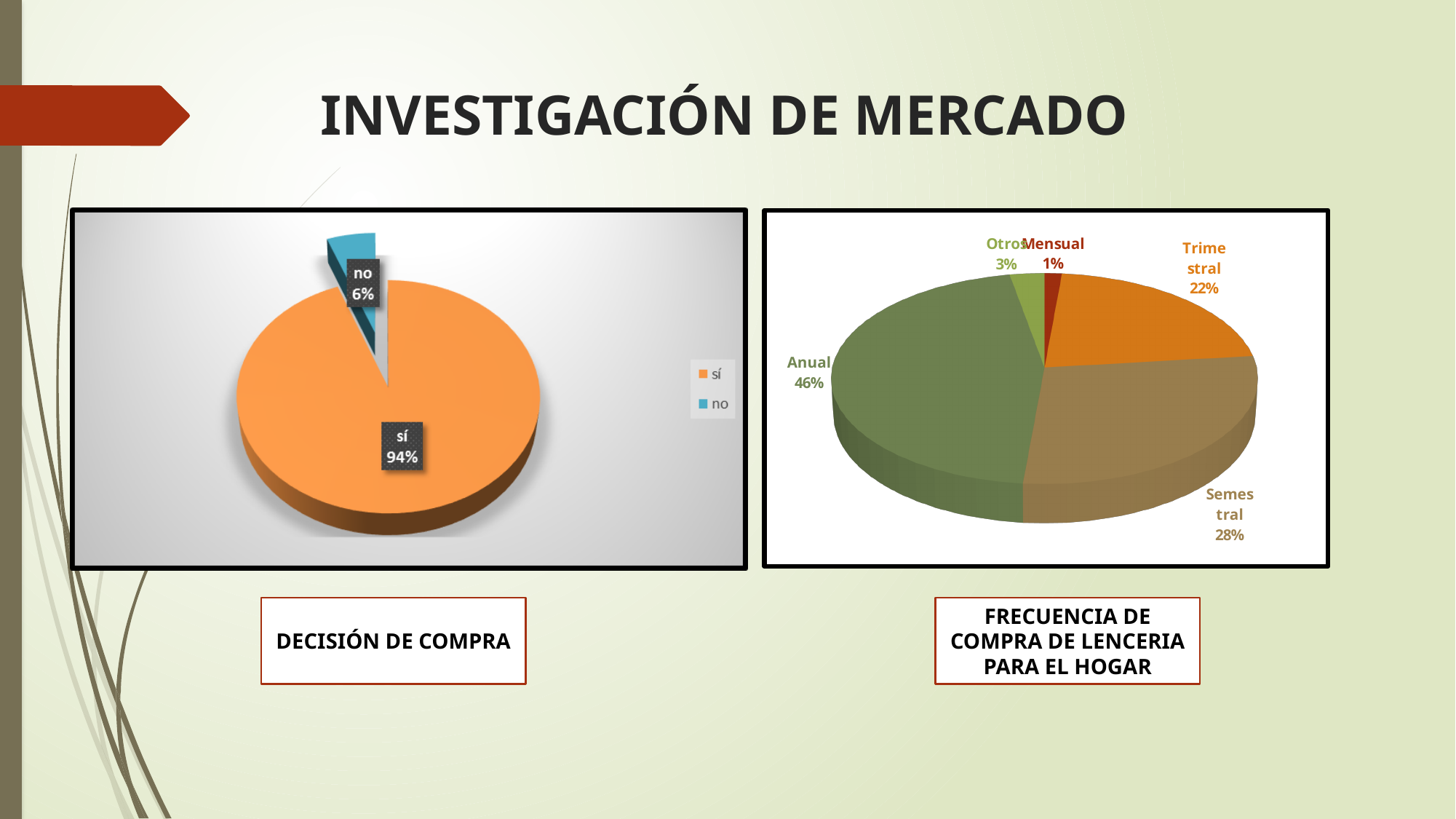
In the FRECUENCIA DE COMPRA DE LENCERIA PARA EL HOGAR chart on the right, which category has the largest share? Anual In the FRECUENCIA DE COMPRA DE LENCERIA PARA EL HOGAR chart on the right, which category has the smallest share? Mensual In the FRECUENCIA DE COMPRA DE LENCERIA PARA EL HOGAR chart on the right, what is the difference between the 'Semestral' and 'Trimestral' shares? 6% In the DECISIÓN DE COMPRA chart on the left, what is the difference between the 'sí' and 'no' shares? 88% In the FRECUENCIA DE COMPRA DE LENCERIA PARA EL HOGAR chart on the right, what share is 'Semestral'? 28% In the DECISIÓN DE COMPRA chart on the left, what share of the pie is 'no'? 6% In the DECISIÓN DE COMPRA chart on the left, what share of the pie is 'sí'? 94% In the FRECUENCIA DE COMPRA DE LENCERIA PARA EL HOGAR chart on the right, what share is 'Trimestral'? 22% How many entries does the legend of the DECISIÓN DE COMPRA chart on the left list? 2 In the FRECUENCIA DE COMPRA DE LENCERIA PARA EL HOGAR chart on the right, how many categories are shown? 5 What kind of chart is the DECISIÓN DE COMPRA chart on the left? Pie chart In the FRECUENCIA DE COMPRA DE LENCERIA PARA EL HOGAR chart on the right, what share is 'Anual'? 46%